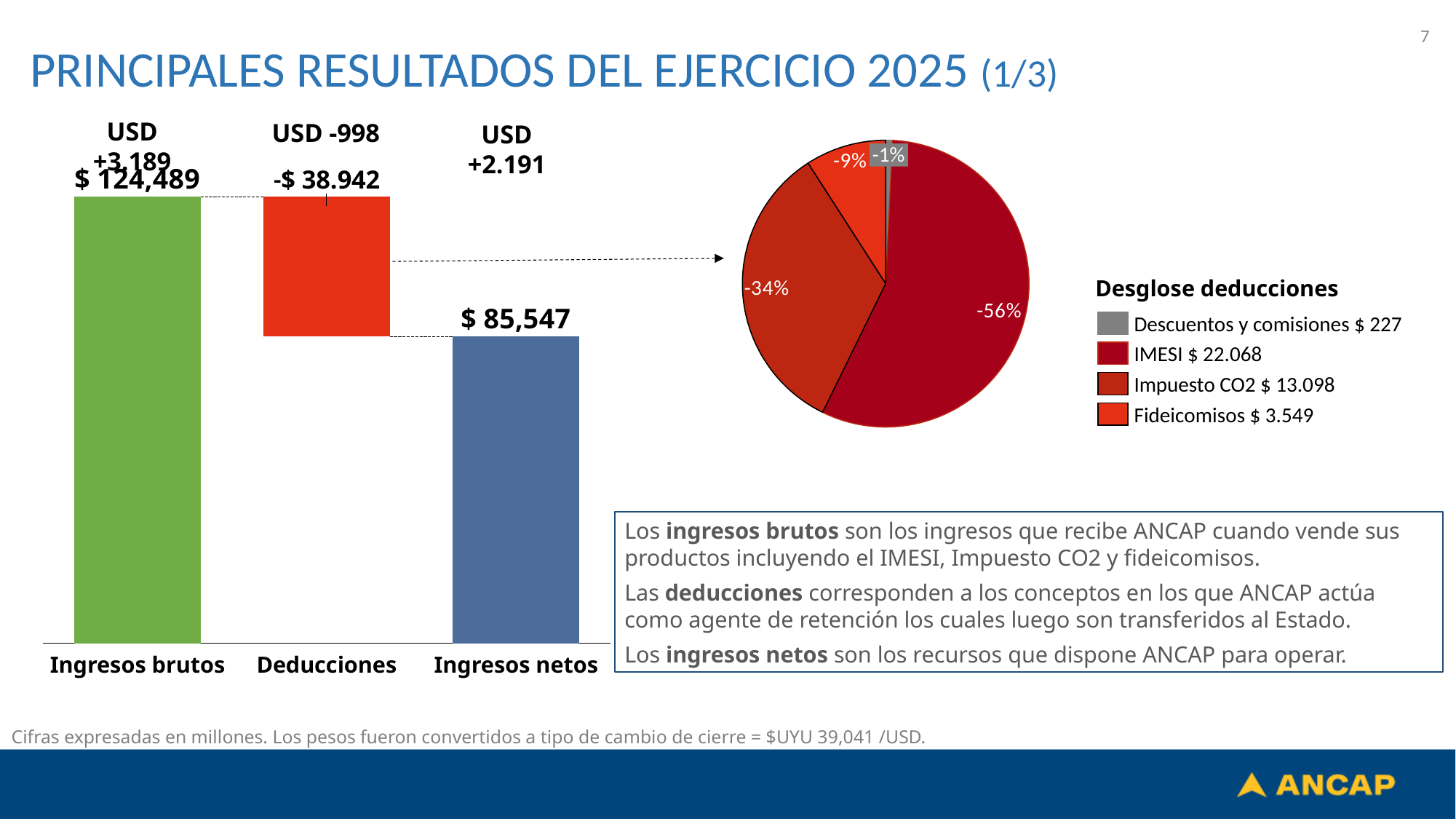
What kind of chart is the chart on the left of the slide? Bar chart On the left bar chart, what value is shown for Deducciones? -$ 38.942 In the Desglose deducciones pie chart, what share does IMESI represent? -56% In the Desglose deducciones pie chart, how many entries does the legend list? 4 On the left bar chart, how many categories are shown on the x axis? 3 On the left bar chart, what USD figure is shown above the Deducciones bar? USD -998 In the Desglose deducciones pie chart, which slice is the smallest? Descuentos y comisiones In the Desglose deducciones pie chart, what value is listed for Impuesto CO2 in the legend? $ 13.098 In the Desglose deducciones pie chart, which is larger: Impuesto CO2 or Fideicomisos? Impuesto CO2 On the left bar chart, what is the value shown for Ingresos netos? $ 85,547 On the left bar chart, what is the value shown for Ingresos brutos? $ 124,489 On the left bar chart, which category has the highest value? Ingresos brutos